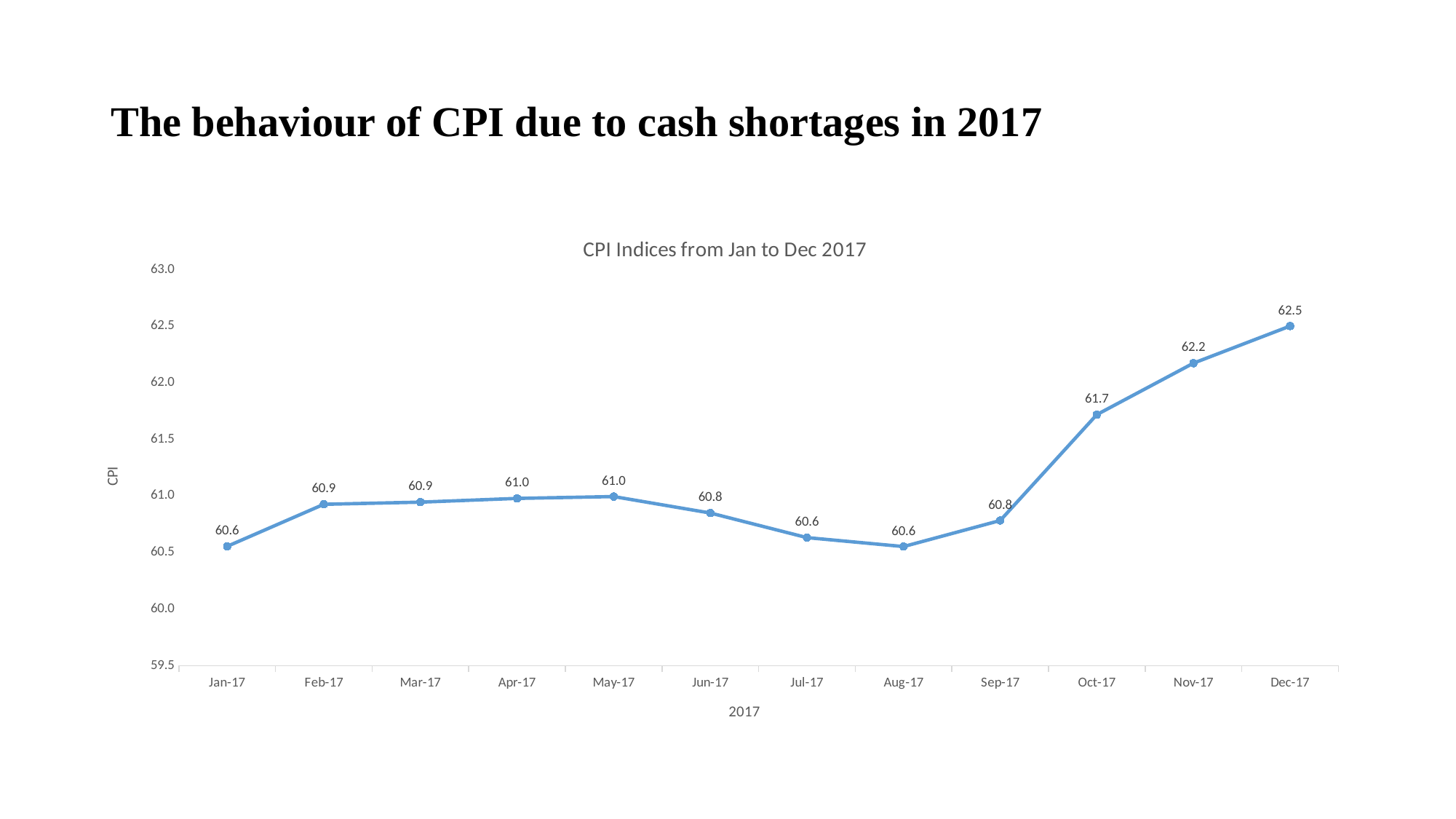
How many months are plotted on the chart? 12 What is the lowest CPI value shown on the chart? 60.6 Which month has the highest CPI value? Dec-17 What is the difference between the CPI values for Oct-17 and Sep-17? 0.9 What is the CPI value for Jun-17? 60.8 What type of chart is shown on the slide? line chart What is the CPI value for Jan-17? 60.6 Which month has a larger CPI value, Nov-17 or Feb-17? Nov-17 What is the title of the chart? CPI Indices from Jan to Dec 2017 Is the CPI value for Oct-17 greater or less than 61.5? greater What is the difference between the CPI values for Dec-17 and Jan-17? 1.9 What is the CPI value for Oct-17? 61.7